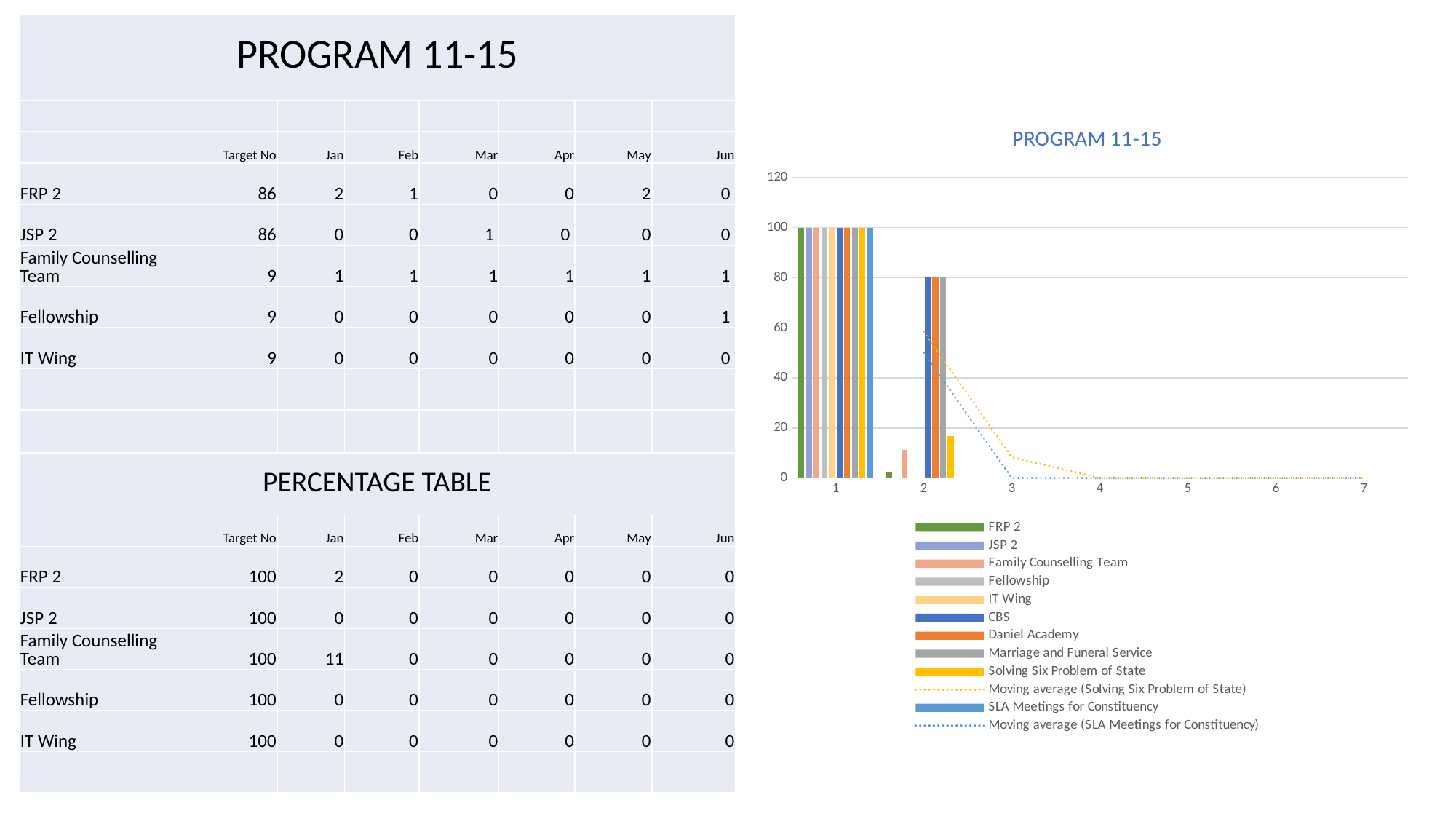
At category 2, which bar is taller: CBS or Solving Six Problem of State? CBS How many entries does the chart's legend list? 12 What is the value of the tallest FRP 2 bar at category 1? 100 What is the title of the chart? PROGRAM 11-15 What is the highest value shown on the chart's y axis? 120 Do the dotted moving average lines rise or fall between category 2 and category 4? fall Is the value of the Solving Six Problem of State bar at category 2 greater or less than 40? less Is the value of the CBS bar at category 2 greater or less than 60? greater Is the value of the Daniel Academy bar at category 2 greater or less than 100? less How many categories are labelled on the x axis of the chart? 7 What kind of chart is shown on the slide? bar chart